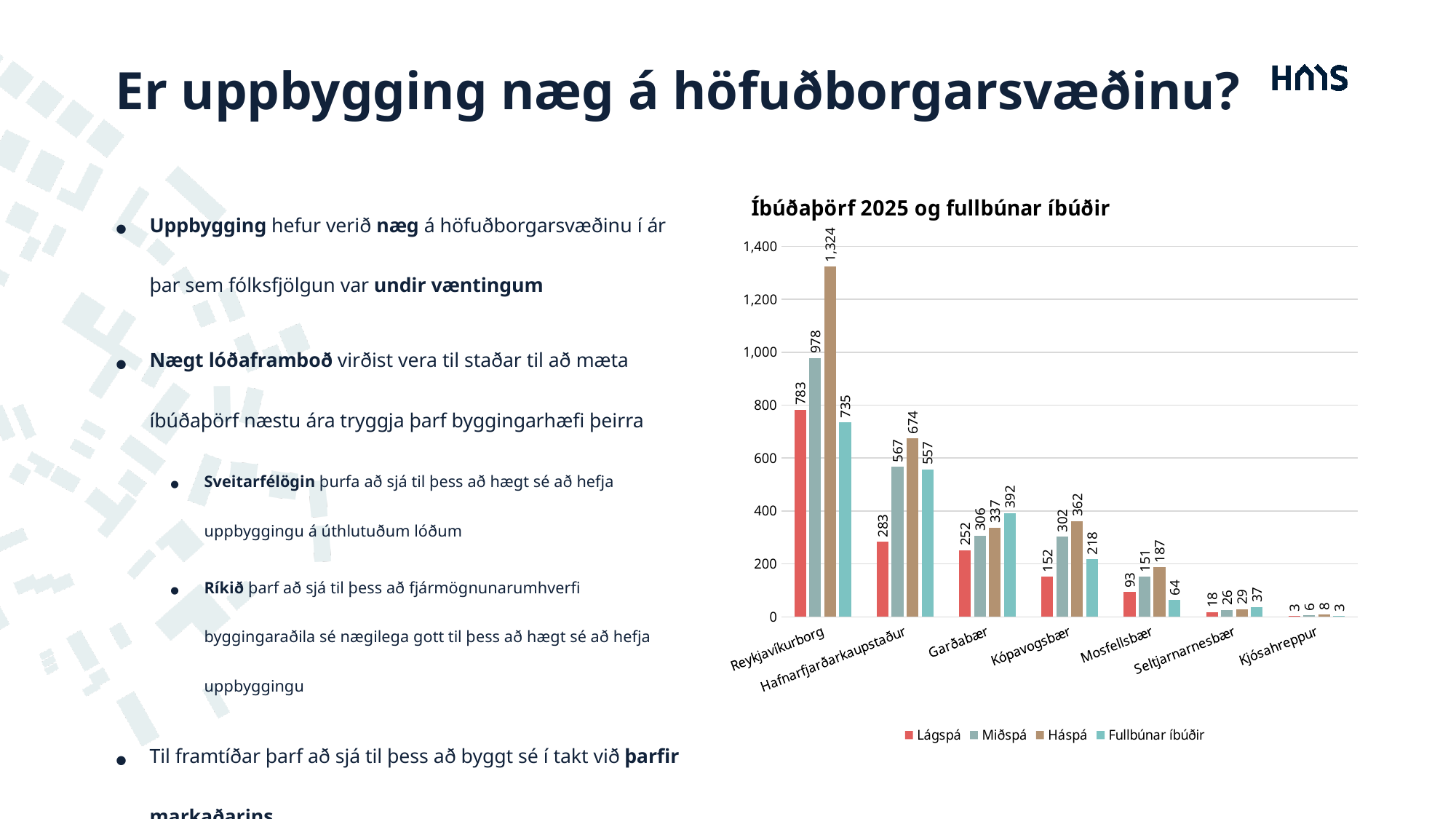
What is the title of the chart? Íbúðaþörf 2025 og fullbúnar íbúðir For Garðabær, which is larger: the Fullbúnar íbúðir value or the Háspá value? Fullbúnar íbúðir Which municipality has the highest Háspá value? Reykjavíkurborg What is the Háspá value for Reykjavíkurborg? 1,324 What is the Fullbúnar íbúðir value for Hafnarfjarðarkaupstaður? 557 What is the difference between the Háspá and Lágspá values for Garðabær? 85 How many municipalities are shown on the x axis? 7 How many series does the legend list? 4 What kind of chart is shown on the slide? Bar chart What is the Miðspá value for Mosfellsbær? 151 What is the Lágspá value for Kópavogsbær? 152 Which municipality has the lowest Fullbúnar íbúðir value? Kjósahreppur